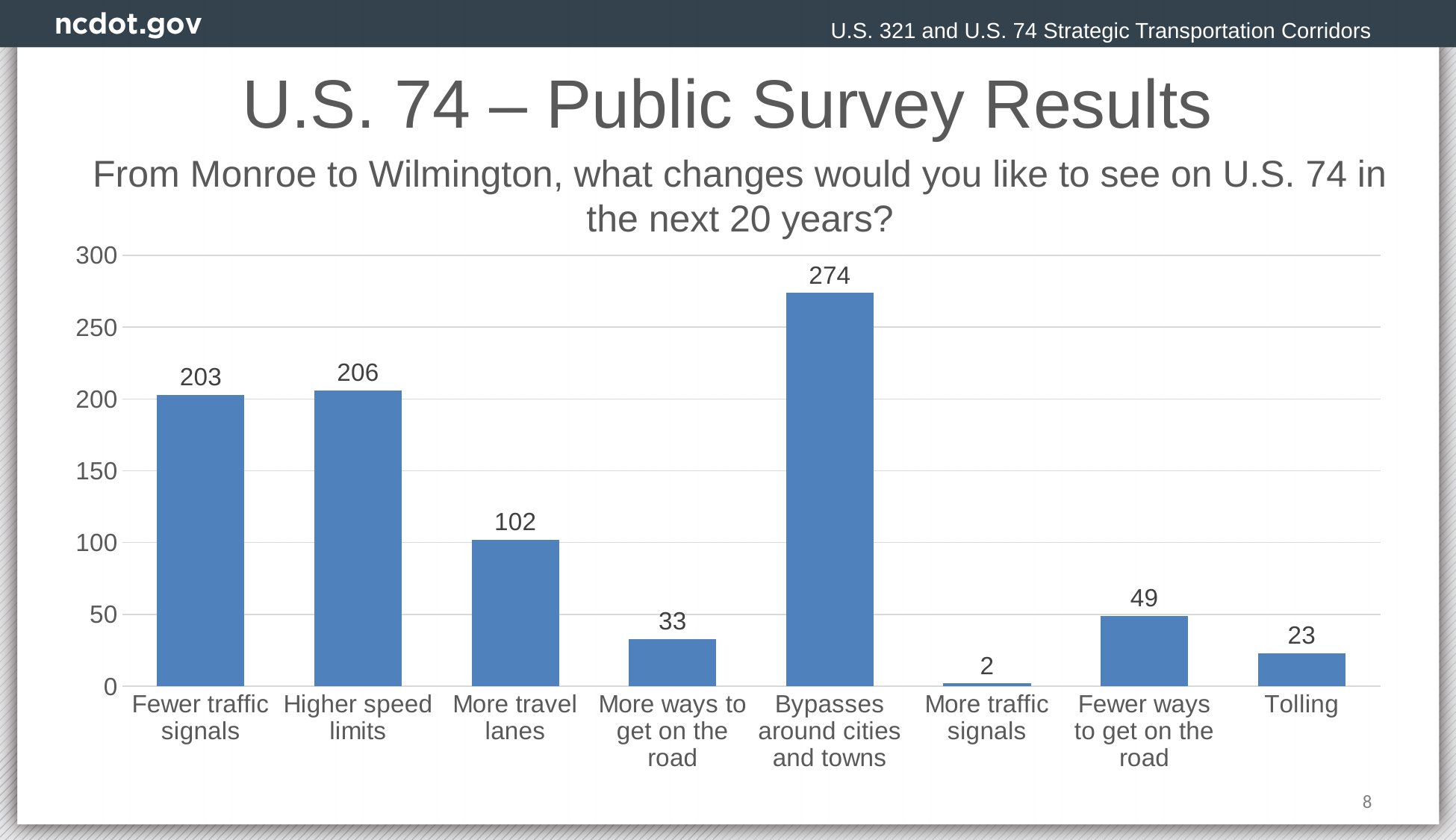
Is the value for "More travel lanes" greater or less than 150? less How many categories are shown on the x axis? 8 What is the value for "More travel lanes"? 102 What is the value for "Tolling"? 23 What question does the chart's subtitle say the survey asked? From Monroe to Wilmington, what changes would you like to see on U.S. 74 in the next 20 years? Which category has the lowest value? More traffic signals What is the difference between the values for "Higher speed limits" and "Fewer traffic signals"? 3 What is the difference between the values for "Bypasses around cities and towns" and "More travel lanes"? 172 What is the value for "Bypasses around cities and towns"? 274 Which category has the highest value? Bypasses around cities and towns What kind of chart is shown on the slide? bar chart Which is larger, the value for "Fewer ways to get on the road" or the value for "More ways to get on the road"? Fewer ways to get on the road